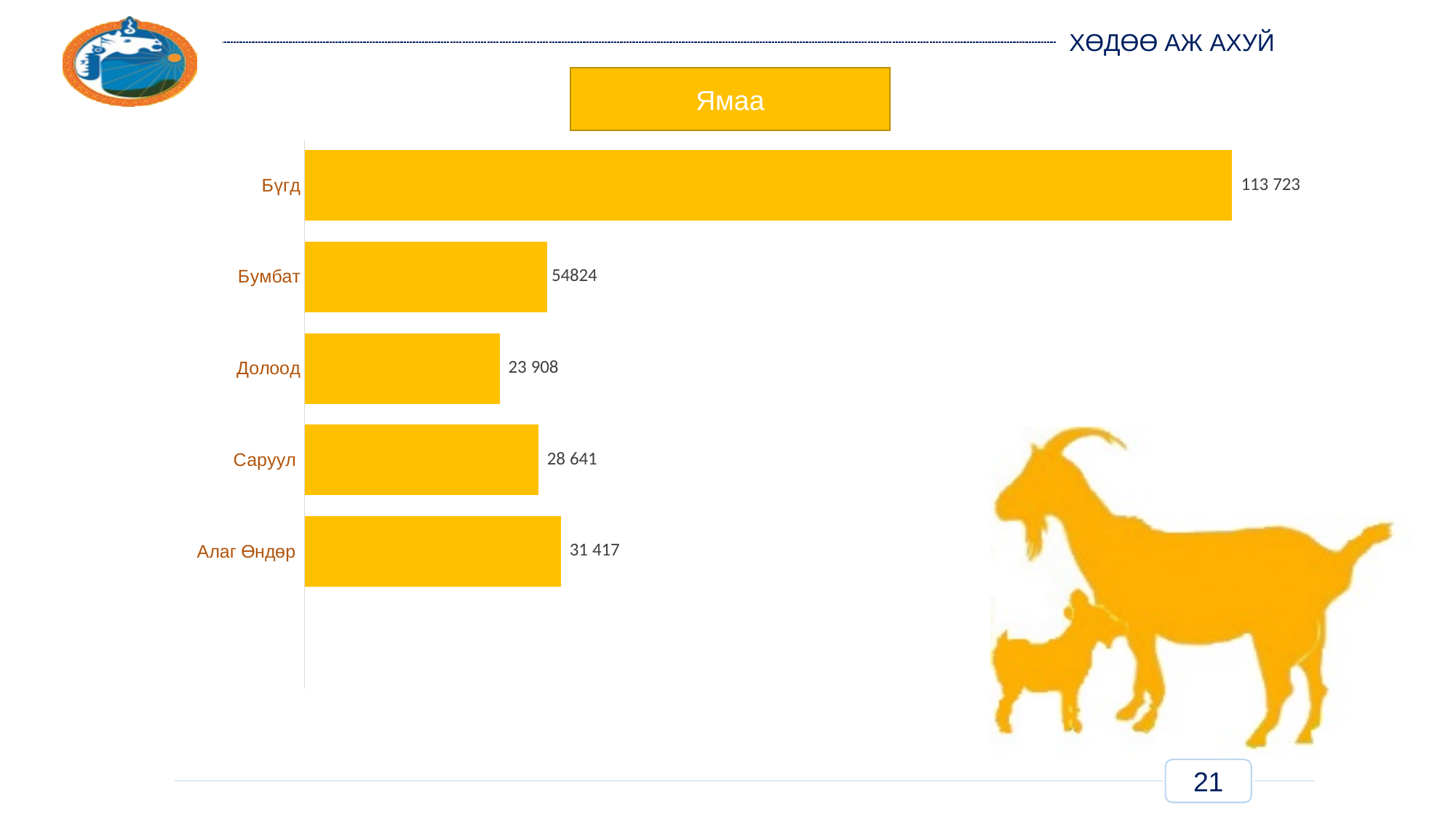
What is the value for Долоод? 23 908 Which category has the lowest value? Долоод What is the value for Алаг Өндөр? 31 417 What kind of chart is shown on the slide? Bar chart What is the difference between the values for Бумбат and Долоод? 30 916 What is the value for Бүгд? 113 723 How many categories are shown in the chart? 5 Which is larger, the value for Саруул or the value for Алаг Өндөр? Алаг Өндөр What is the value for Саруул? 28 641 Which category has the highest value? Бүгд What is the difference between the values for Алаг Өндөр and Саруул? 2 776 What is the value for Бумбат? 54824